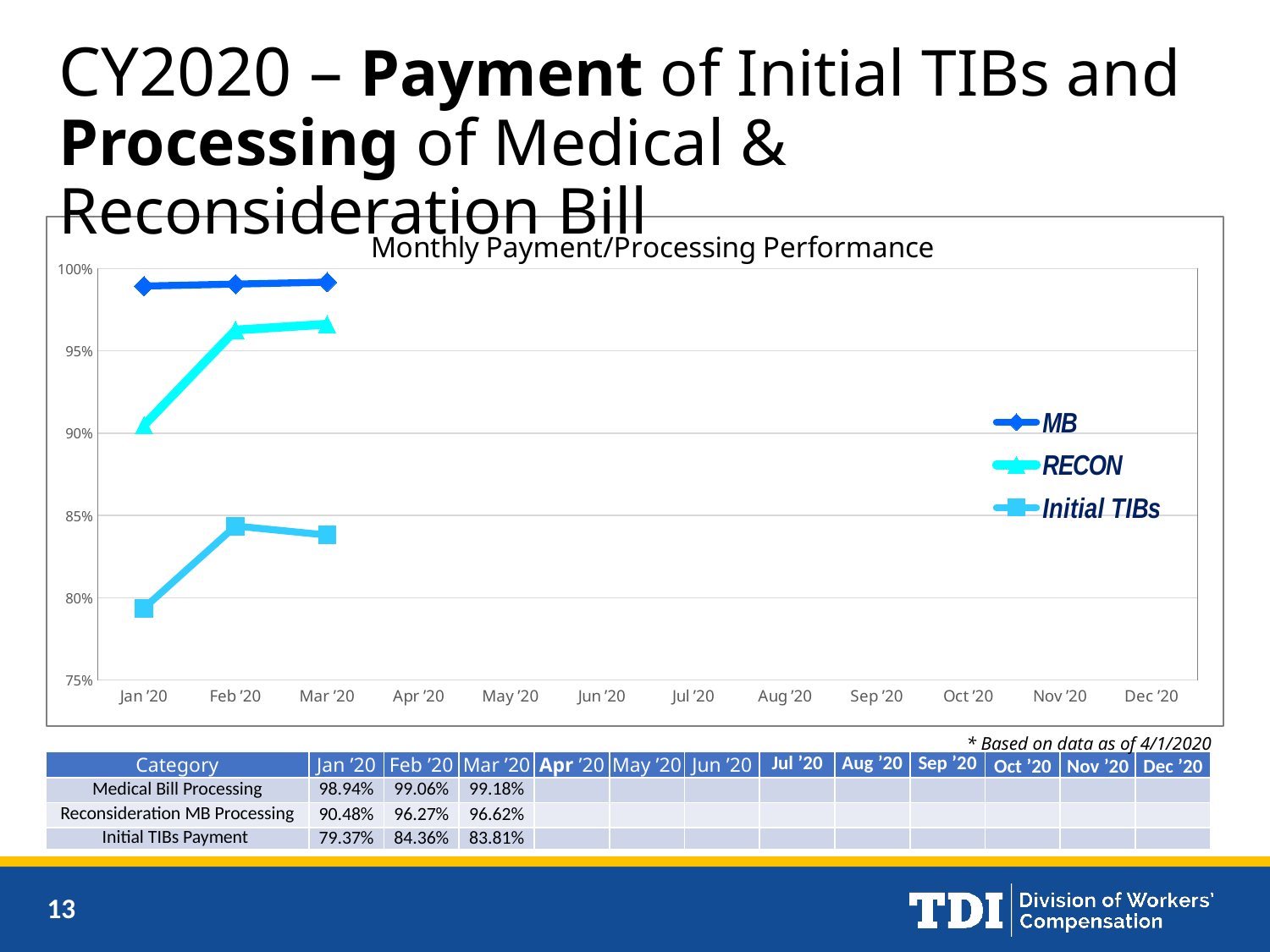
Is the Initial TIBs value for Jan '20 greater or less than 80%? less What is the difference between the Reconsideration MB Processing values for Feb '20 and Jan '20? 5.79% What is the Medical Bill Processing value for Mar '20? 99.18% What is the Initial TIBs Payment value for Feb '20? 84.36% Does the RECON series rise or fall from Jan '20 to Mar '20? rise How many series does the chart legend list? 3 What is the Reconsideration MB Processing value for Jan '20? 90.48% Which is larger, the Initial TIBs Payment value for Feb '20 or for Mar '20? Feb '20 What is the title of the chart? Monthly Payment/Processing Performance Which series has the lowest value in Jan '20? Initial TIBs What kind of chart is shown on the slide? line chart Which series has the highest value in Mar '20? MB